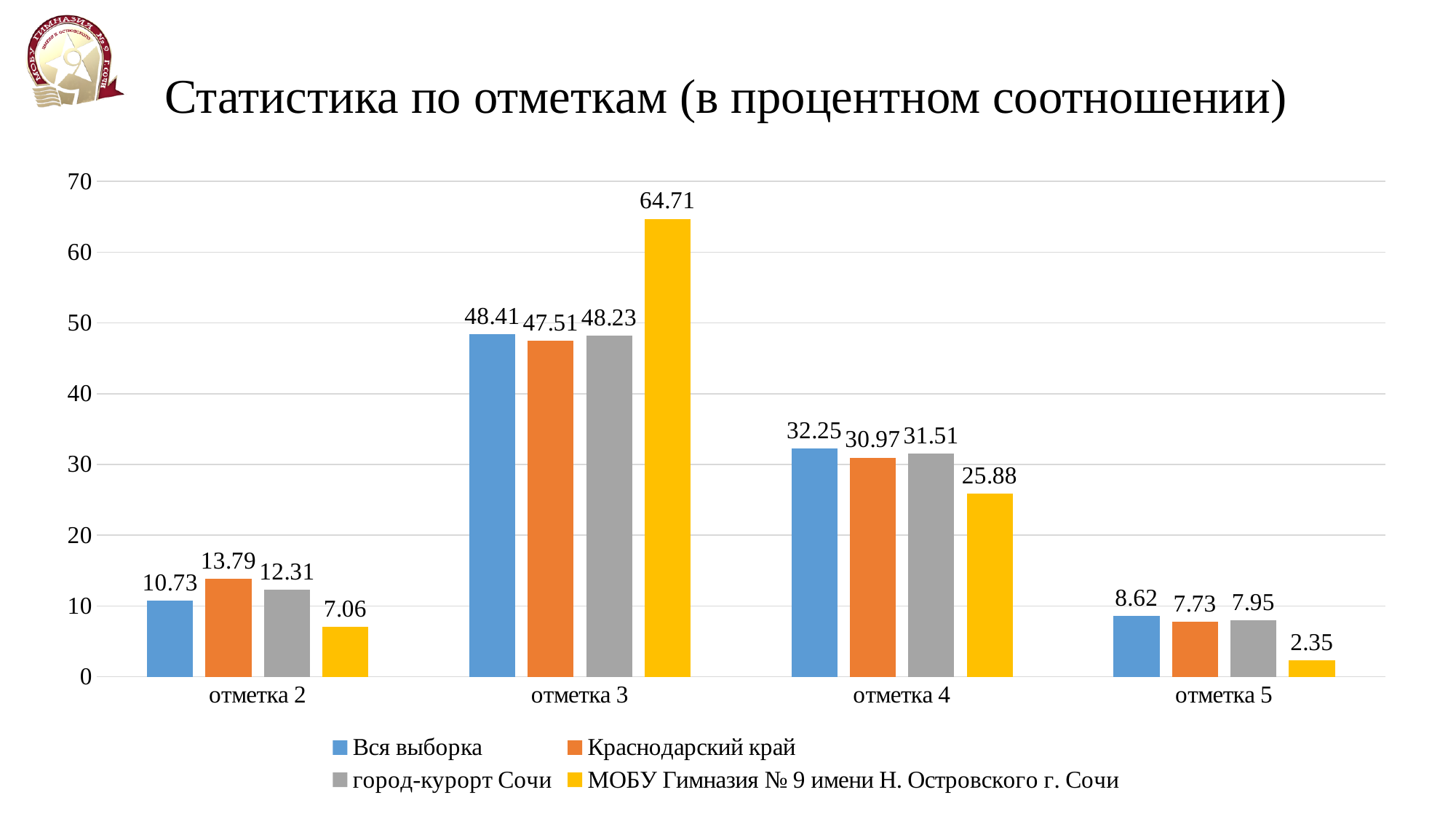
At отметка 4, which is larger: город-курорт Сочи or МОБУ Гимназия № 9 имени Н. Островского г. Сочи? город-курорт Сочи How many series does the legend list? 4 What is the value for Вся выборка at отметка 4? 32.25 Which category has the highest value for МОБУ Гимназия № 9 имени Н. Островского г. Сочи? отметка 3 What is the difference between the МОБУ Гимназия № 9 value and the Вся выборка value at отметка 3? 16.30 What kind of chart is shown on the slide? bar chart What is the value for город-курорт Сочи at отметка 5? 7.95 What is the title of the chart? Статистика по отметкам (в процентном соотношении) Which category has the lowest value for Вся выборка? отметка 5 What is the value for Краснодарский край at отметка 2? 13.79 What is the value for МОБУ Гимназия № 9 имени Н. Островского г. Сочи at отметка 3? 64.71 How many categories are shown on the x axis? 4